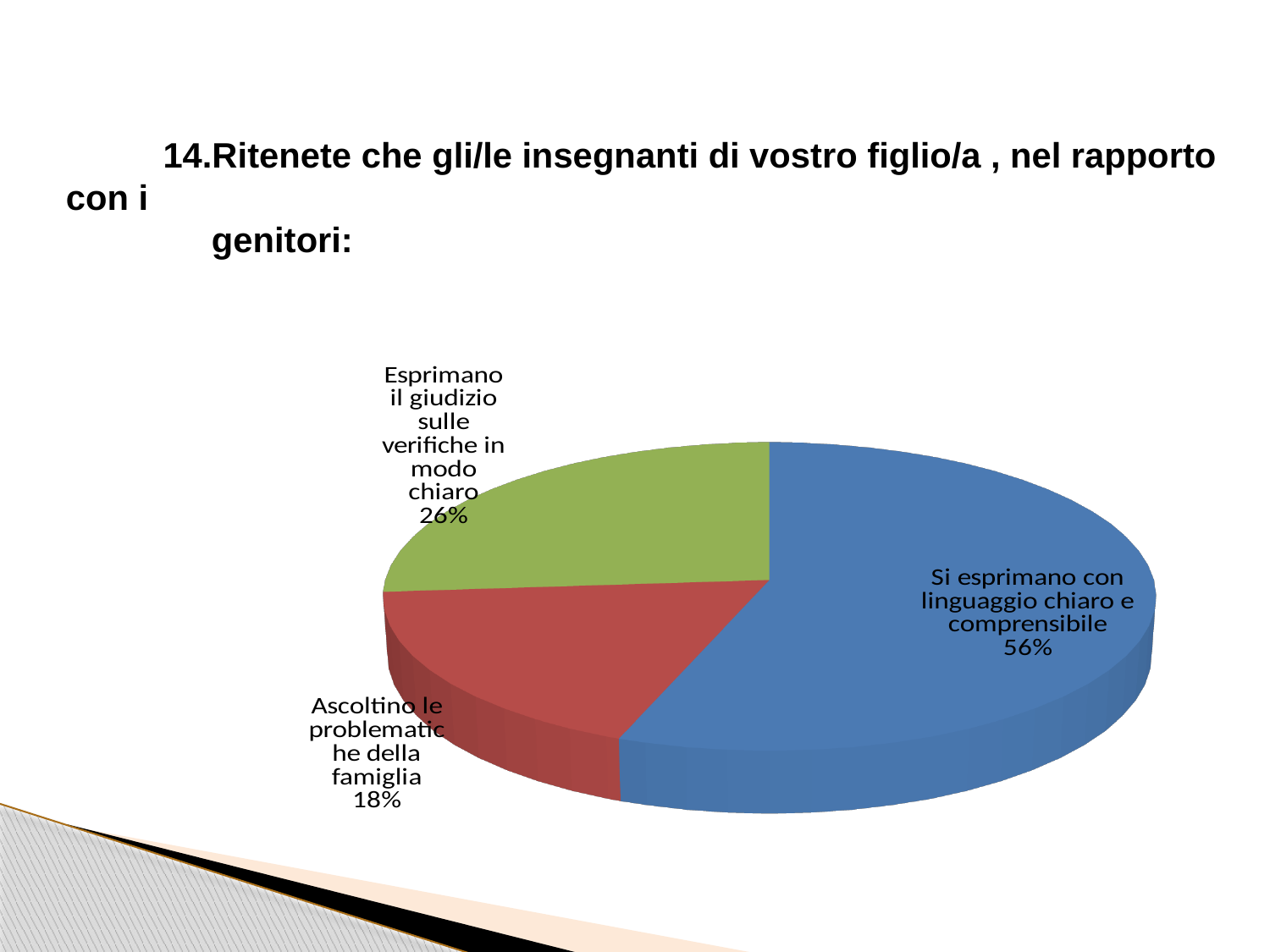
What kind of chart is shown on the slide? Pie chart What is the difference in percentage points between the "Esprimano il giudizio sulle verifiche in modo chiaro" slice and the "Ascoltino le problematiche della famiglia" slice? 8 percentage points What share of the pie is labelled "Ascoltino le problematiche della famiglia"? 18% What share of the pie is labelled "Esprimano il giudizio sulle verifiche in modo chiaro"? 26% What colour is the slice labelled "Si esprimano con linguaggio chiaro e comprensibile"? Blue Which is larger: the "Esprimano il giudizio sulle verifiche in modo chiaro" slice or the "Ascoltino le problematiche della famiglia" slice? Esprimano il giudizio sulle verifiche in modo chiaro What colour is the slice labelled "Esprimano il giudizio sulle verifiche in modo chiaro"? Green Which slice of the pie is the largest? Si esprimano con linguaggio chiaro e comprensibile How many slices does the pie chart have? 3 What share of the pie is labelled "Si esprimano con linguaggio chiaro e comprensibile"? 56% Which slice of the pie is the smallest? Ascoltino le problematiche della famiglia What is the difference in percentage points between the "Si esprimano con linguaggio chiaro e comprensibile" slice and the "Esprimano il giudizio sulle verifiche in modo chiaro" slice? 30 percentage points